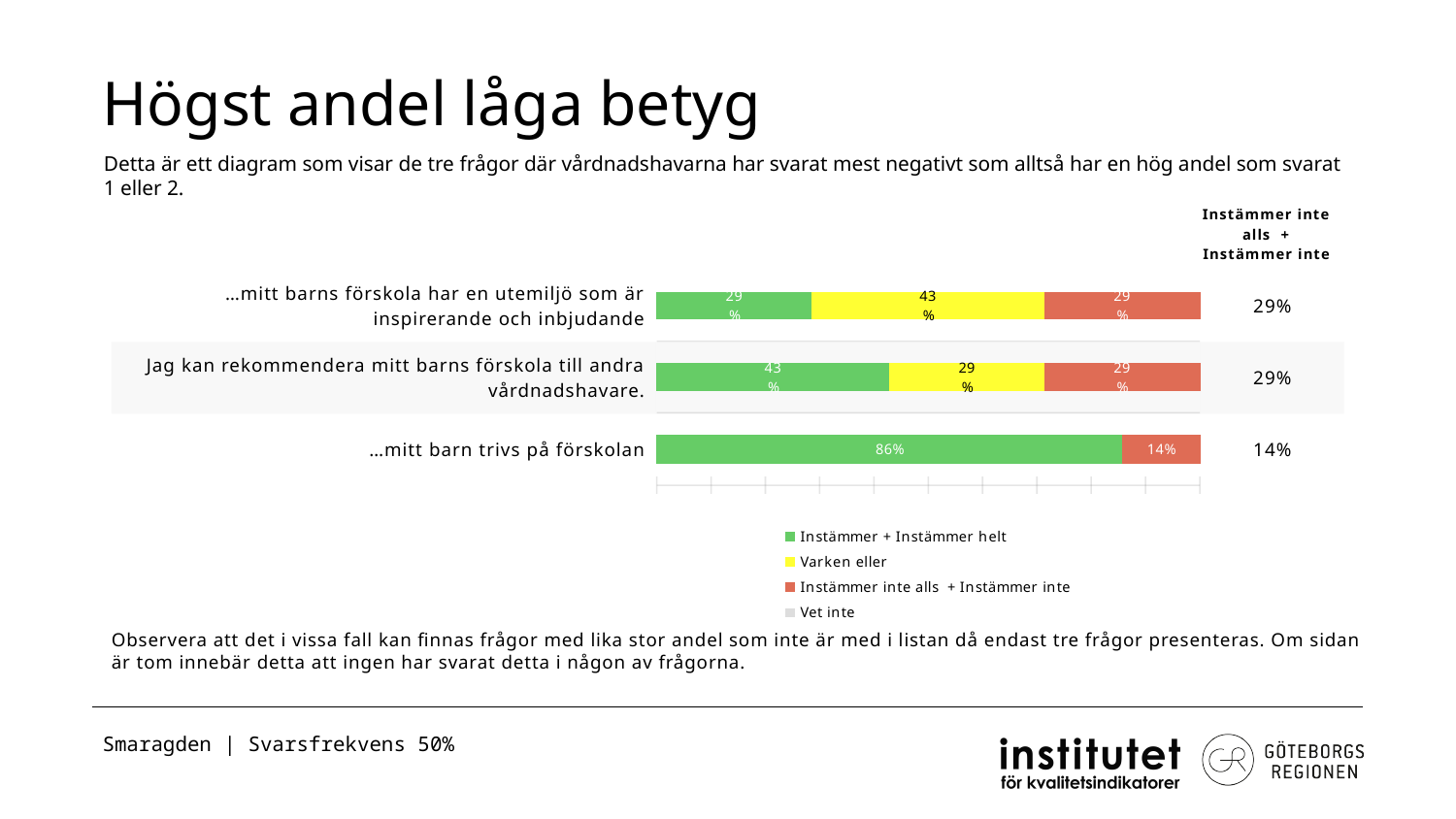
Which is larger for '…mitt barns förskola har en utemiljö som är inspirerande och inbjudande': the 'Varken eller' value or the 'Instämmer + Instämmer helt' value? Varken eller What is the value of 'Instämmer + Instämmer helt' for 'Jag kan rekommendera mitt barns förskola till andra vårdnadshavare.'? 43% How many series does the legend list? 4 What is the value of 'Varken eller' for '…mitt barns förskola har en utemiljö som är inspirerande och inbjudande'? 43% Which category has the highest 'Instämmer + Instämmer helt' value? …mitt barn trivs på förskolan What is the value of 'Instämmer + Instämmer helt' for '…mitt barn trivs på förskolan'? 86% How many categories (questions) are plotted in the chart? 3 What is the value of 'Instämmer inte alls + Instämmer inte' for '…mitt barn trivs på förskolan'? 14% What type of chart is shown on the slide? bar chart Which category has the lowest 'Instämmer inte alls + Instämmer inte' value? …mitt barn trivs på förskolan What is the title of the chart slide? Högst andel låga betyg What is the difference between the 'Instämmer + Instämmer helt' values for '…mitt barn trivs på förskolan' and 'Jag kan rekommendera mitt barns förskola till andra vårdnadshavare.'? 43%